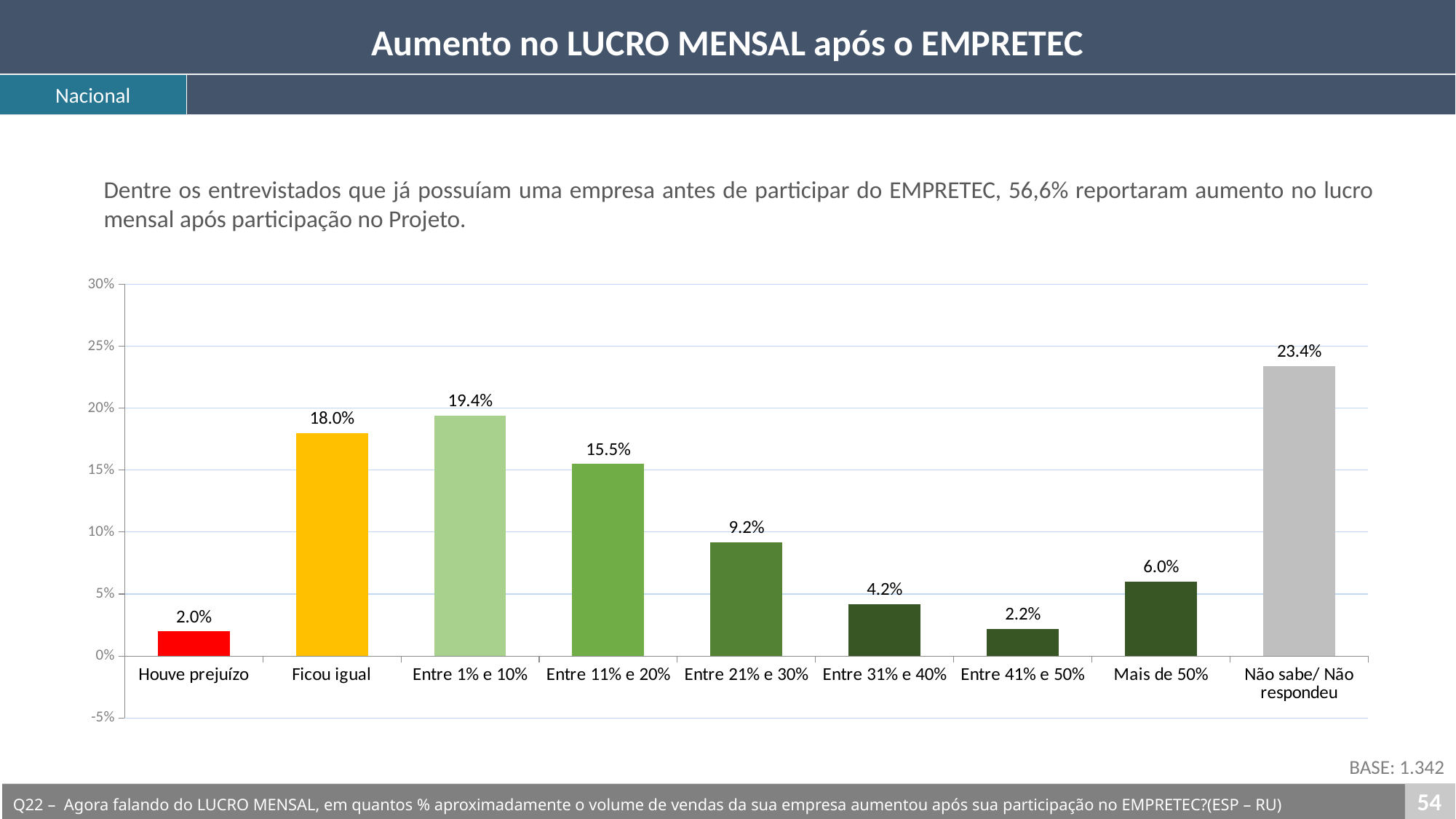
What kind of chart is shown on the slide? bar chart What is the difference between "Entre 31% e 40%" and "Entre 41% e 50%"? 2.0% Is the value for "Não sabe/ Não respondeu" greater or less than 20%? greater What is the value for "Houve prejuízo"? 2.0% What is the value for "Entre 1% e 10%"? 19.4% Which category has the highest value? Não sabe/ Não respondeu Which is larger, "Entre 21% e 30%" or "Mais de 50%"? Entre 21% e 30% Which category has the lowest value? Houve prejuízo How many categories are shown on the x axis? 9 What is the difference between "Ficou igual" and "Entre 11% e 20%"? 2.5% What is the value for "Mais de 50%"? 6.0% What colour is the bar for "Houve prejuízo"? red